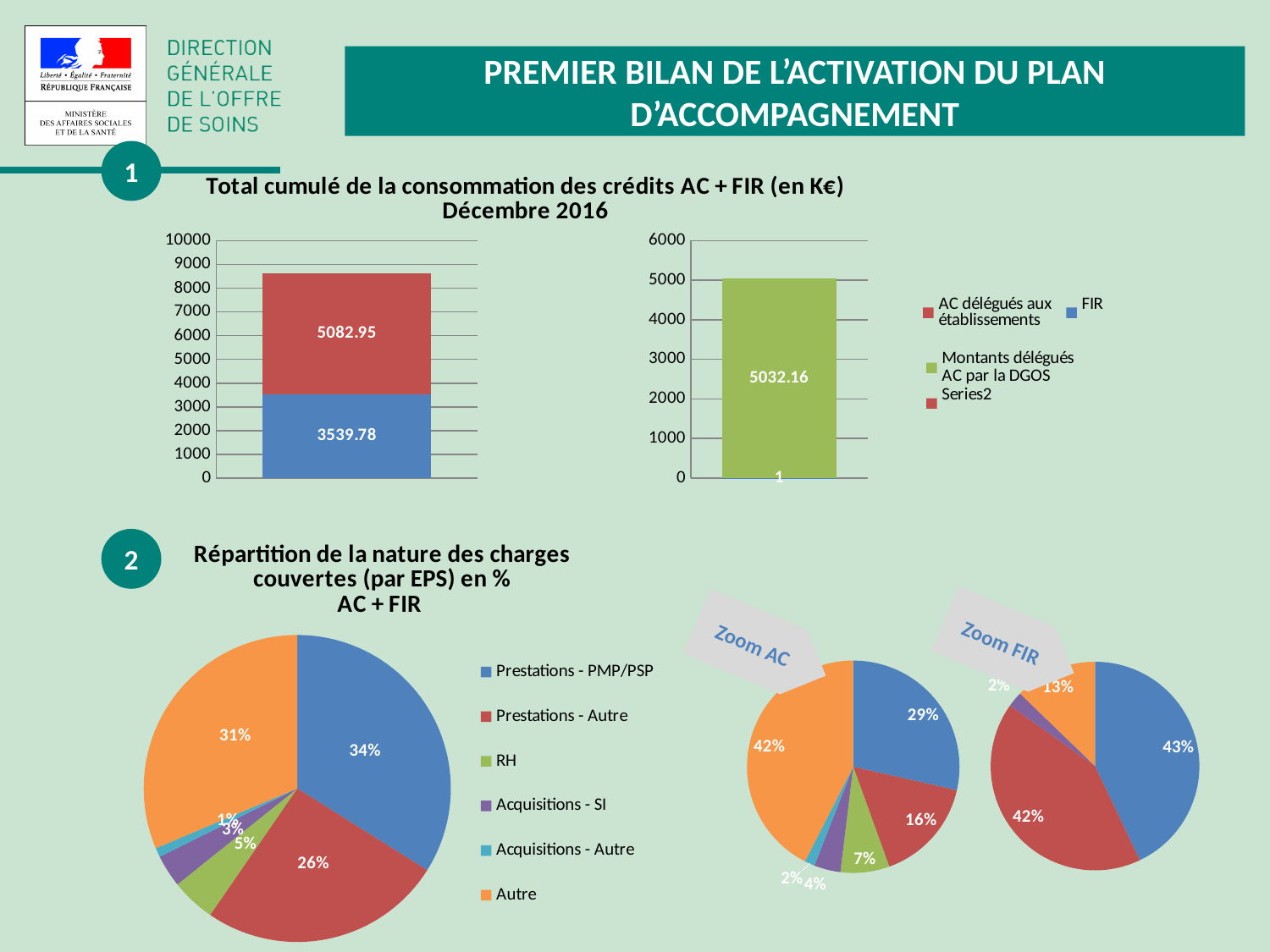
In the 'Zoom AC' pie chart, what is the share of the largest slice? 42% In the 'Zoom AC' pie chart, which is larger: the blue slice or the red slice? The blue slice (29%) In the 'Zoom FIR' pie chart, what is the share of the blue slice? 43% How many entries does the legend of the pie chart 'Répartition de la nature des charges couvertes (par EPS) en % AC + FIR' list? 6 In the top-right bar chart, what is the value of 'Montants délégués AC par la DGOS'? 5032.16 In the stacked bar chart 'Total cumulé de la consommation des crédits AC + FIR', what is the value of the FIR segment? 3539.78 What kind of chart is the top-right chart showing 'Montants délégués AC par la DGOS'? Bar chart In the stacked bar chart 'Total cumulé de la consommation des crédits AC + FIR', what is the value of the 'AC délégués aux établissements' segment? 5082.95 In the stacked bar chart 'Total cumulé de la consommation des crédits AC + FIR', what is the total of the stacked bar? 8622.73 In the pie chart 'Répartition de la nature des charges couvertes (par EPS) en % AC + FIR', which category has the smallest share? Acquisitions - Autre In the stacked bar chart 'Total cumulé de la consommation des crédits AC + FIR', what is the difference between the AC segment and the FIR segment? 1543.17 In the pie chart 'Répartition de la nature des charges couvertes (par EPS) en % AC + FIR', what is the share of 'Prestations - PMP/PSP'? 34%